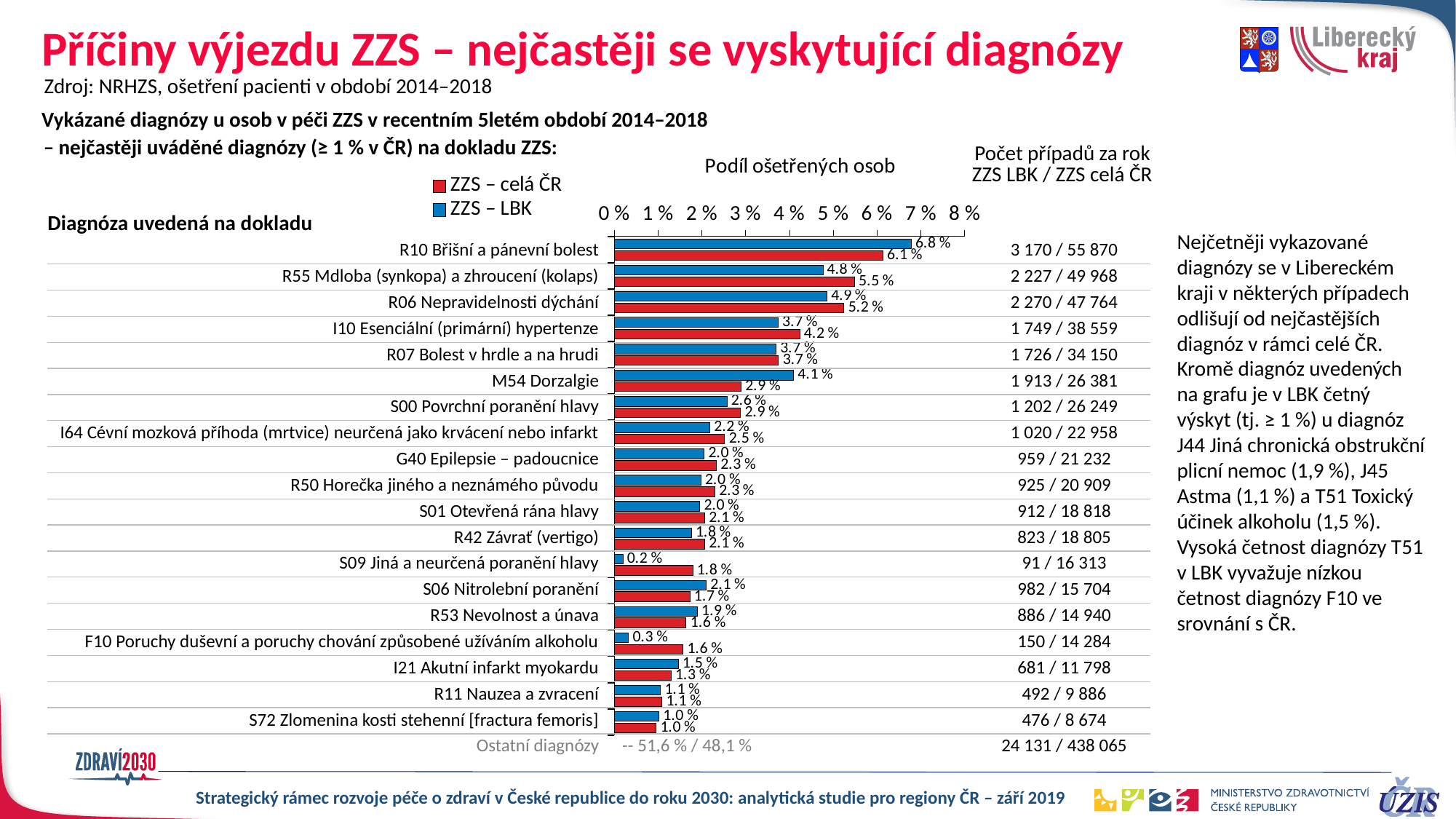
What is the difference between the ZZS – LBK and ZZS – celá ČR values for M54 Dorzalgie? 1.2 % Is the ZZS – celá ČR value for I10 Esenciální (primární) hypertenze greater or less than 3 %? greater For F10 Poruchy duševní a poruchy chování způsobené užíváním alkoholu, which series has the larger value, ZZS – LBK or ZZS – celá ČR? ZZS – celá ČR What is the ZZS – celá ČR value for R55 Mdloba (synkopa) a zhroucení (kolaps)? 5.5 % What is the ZZS – LBK value for R10 Břišní a pánevní bolest? 6.8 % Which diagnosis has the lowest ZZS – LBK value? S09 Jiná a neurčená poranění hlavy What is the ZZS – LBK value for S09 Jiná a neurčená poranění hlavy? 0.2 % What kind of chart is shown on the slide? bar chart Which colour represents the ZZS – LBK series in the chart? blue How many diagnosis categories are plotted in the chart? 19 How many series does the chart legend list? 2 Which diagnosis has the highest ZZS – LBK value? R10 Břišní a pánevní bolest